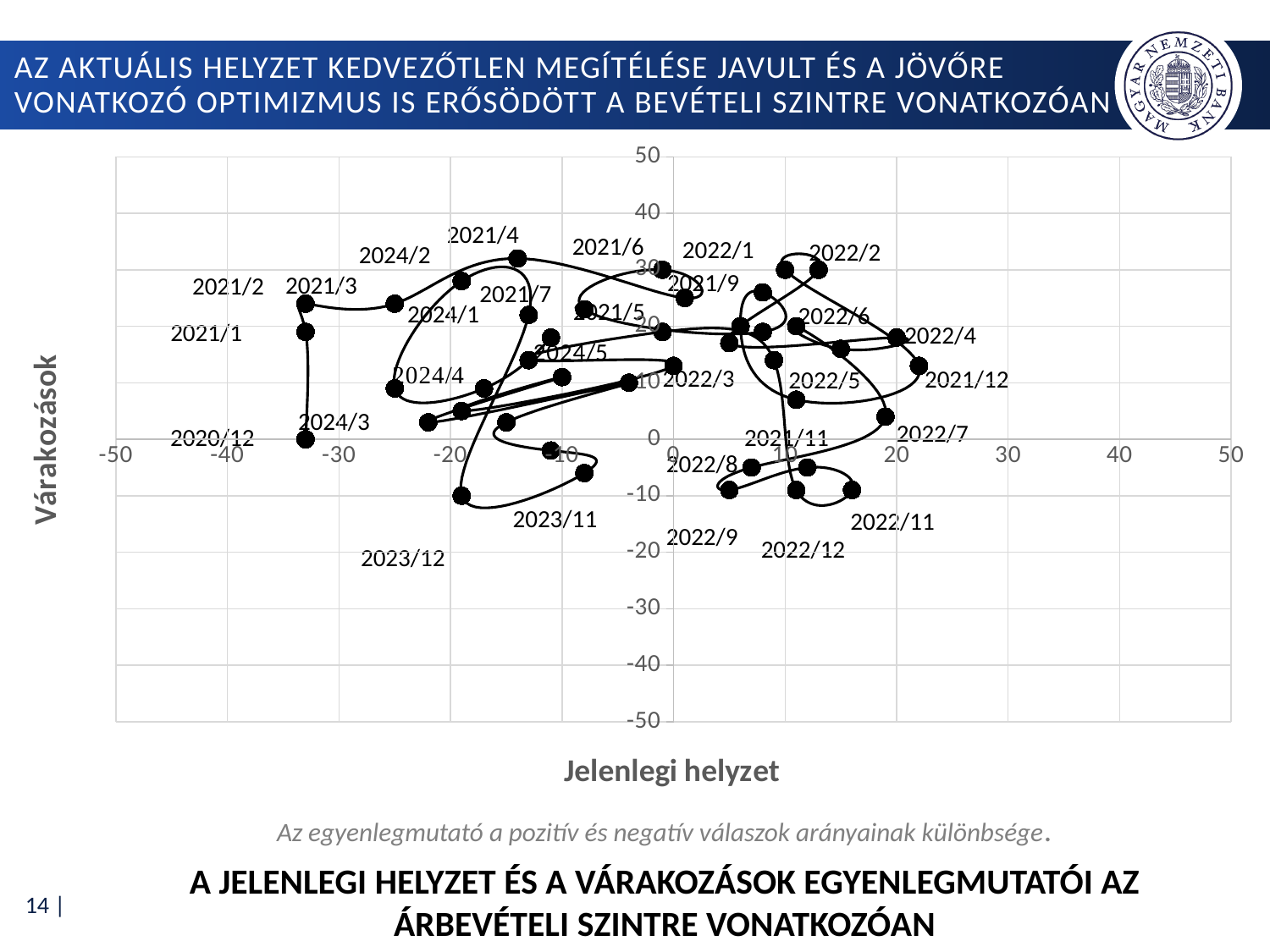
Which point has the larger Jelenlegi helyzet (horizontal) value, 2021/1 or 2021/12? 2021/12 Is the Jelenlegi helyzet (horizontal) value for the point labelled 2021/1 greater or less than -20? less Is the Várakozások (vertical) value for the point labelled 2024/4 greater or less than 0? greater Is the Jelenlegi helyzet (horizontal) value for the point labelled 2022/4 greater or less than 10? greater What kind of chart is shown on the slide? Scatter chart Which point has the higher Várakozások (vertical) value, 2022/2 or 2022/11? 2022/2 What is the title of the horizontal axis of the chart? Jelenlegi helyzet What is the title of the vertical axis of the chart? Várakozások